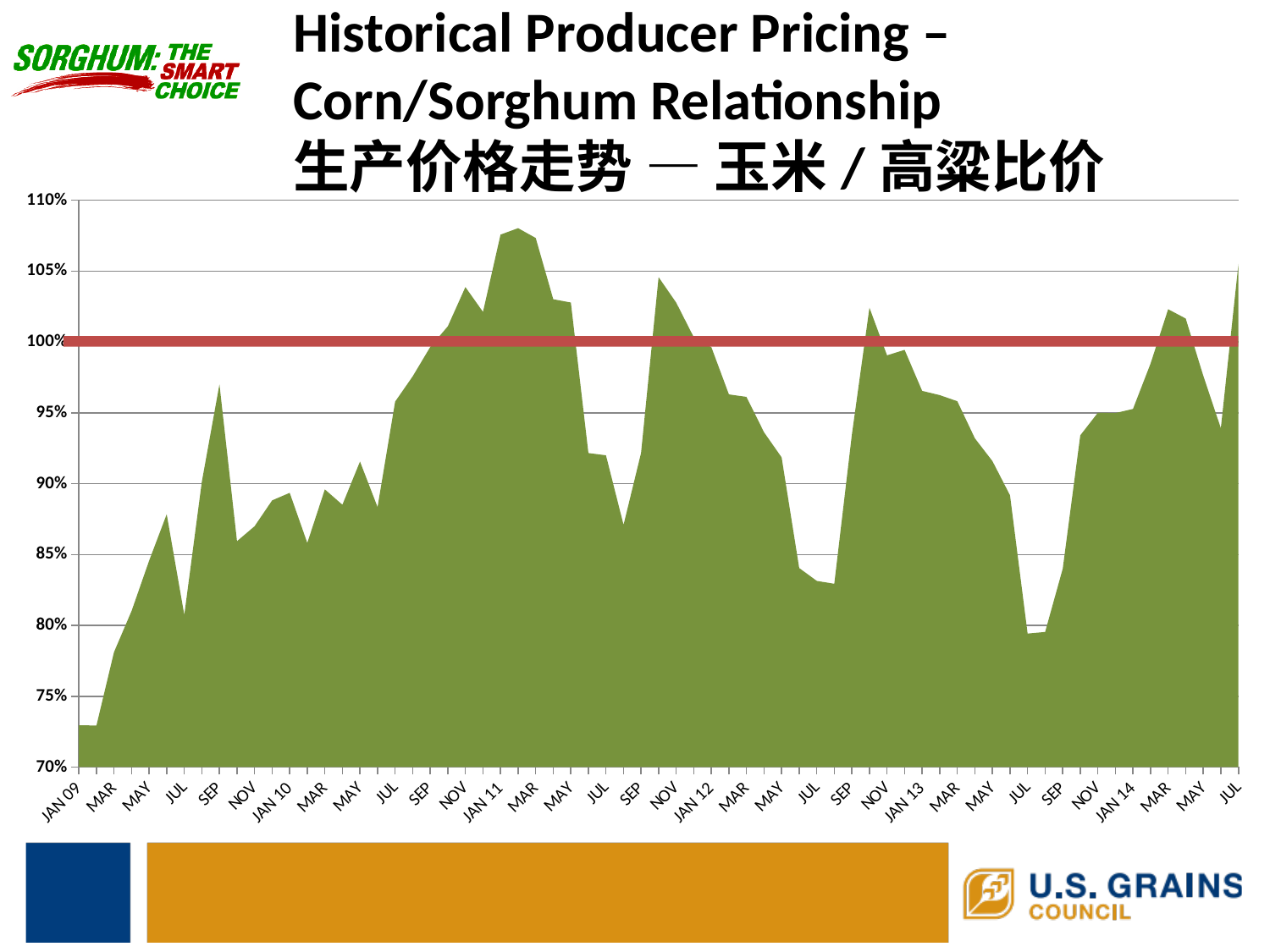
How many January year labels (JAN 09 through JAN 14) appear on the x axis? 6 Is the value for JUL 13 greater or less than 80%? less Is the value for JAN 09 greater or less than 75%? less Is the value for JUL 12 greater or less than 85%? less What is the title of the chart on the slide (English part)? Historical Producer Pricing – Corn/Sorghum Relationship At which x-axis label is the chart's lowest value? JAN 09 Do the values generally rise or fall from JAN 09 to MAR 11? rise At what level is the horizontal red reference line drawn on the chart? 100% What kind of chart is shown on the slide? Area chart Around which x-axis label does the chart reach its highest value? JAN 11